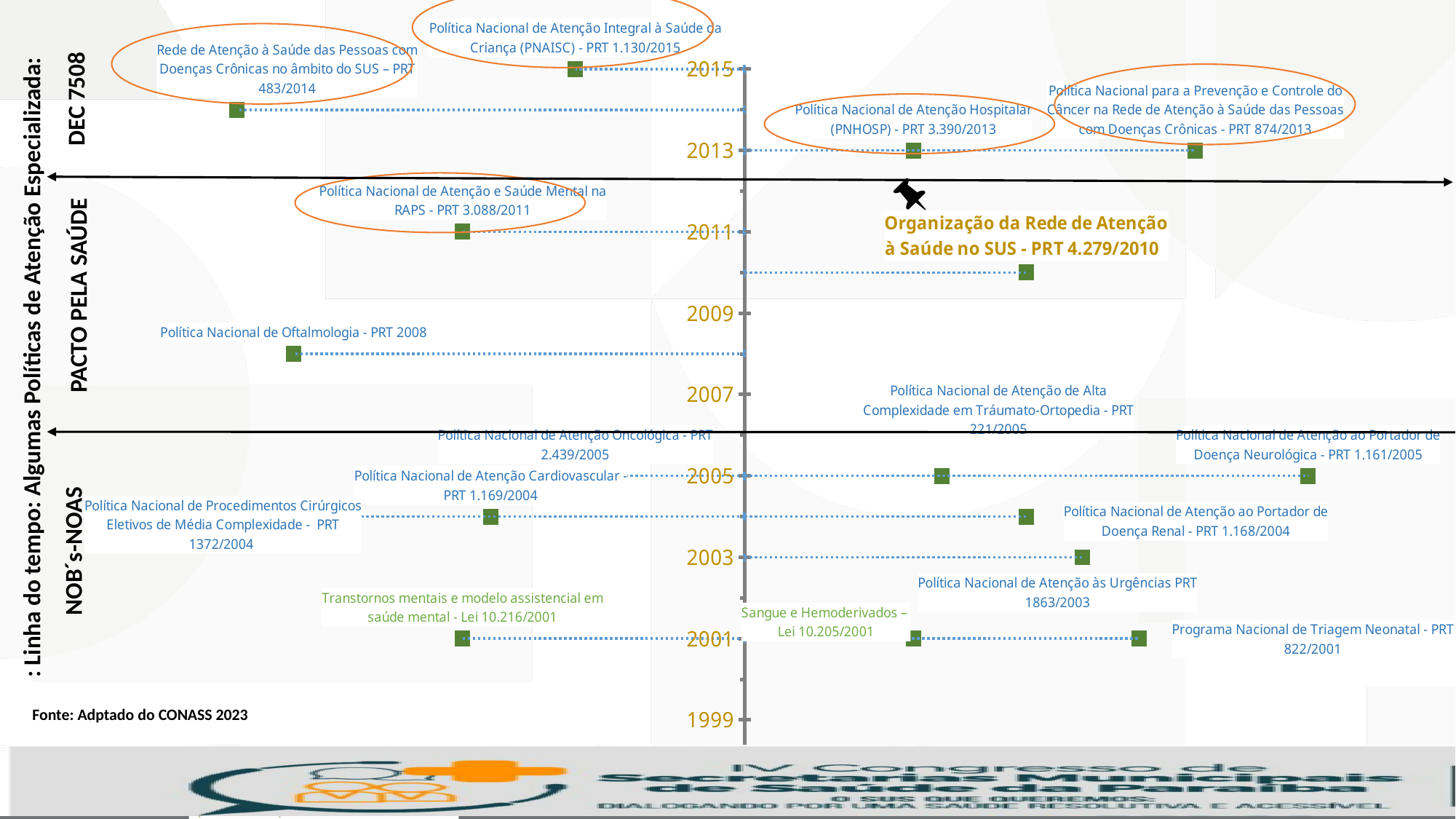
How many years separate the Política Nacional de Oftalmologia (2008) from the PNAISC (2015) on the timeline? 7 years Which is plotted later on the timeline: the Política Nacional de Oftalmologia or the Política Nacional de Atenção e Saúde Mental na RAPS? Política Nacional de Atenção e Saúde Mental na RAPS What kind of chart is shown on the slide? A timeline Do the years on the vertical axis increase or decrease from bottom to top? Increase What is the latest year labelled on the vertical axis of the timeline? 2015 In which year is the Política Nacional de Oftalmologia plotted on the timeline? 2008 Which policy is plotted at the most recent year on the timeline? Política Nacional de Atenção Integral à Saúde da Criança (PNAISC) - PRT 1.130/2015 Is the year for the Política Nacional de Oftalmologia greater or less than 2009? less Which policy is plotted at 2003 on the timeline? Política Nacional de Atenção às Urgências PRT 1863/2003 What is the earliest year labelled on the vertical axis of the timeline? 1999 In which year is the Política Nacional de Atenção e Saúde Mental na RAPS (PRT 3.088) plotted? 2011 How many year labels are shown on the vertical axis of the timeline? 9